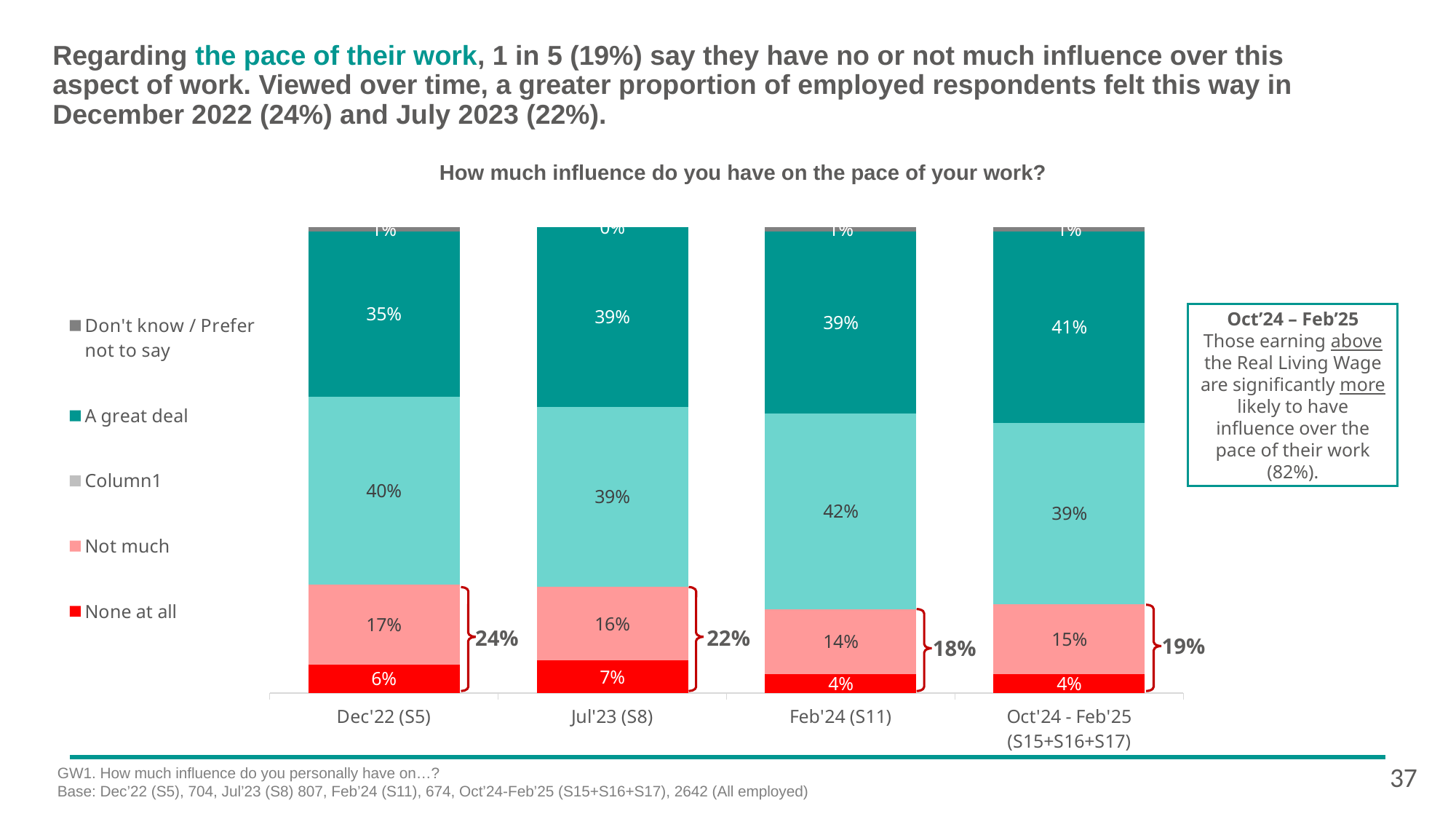
How many time periods are shown on the x axis? 4 Does the 'A great deal' value rise or fall from Dec'22 (S5) to Oct'24 - Feb'25 (S15+S16+S17)? Rise What is the difference between the 'Not much' values for Dec'22 (S5) and Feb'24 (S11)? 3 percentage points How many series does the legend list? 5 Which period has the highest 'A great deal' value? Oct'24 - Feb'25 (S15+S16+S17) What is the 'None at all' value for Jul'23 (S8)? 7% What percentage of respondents said they have 'A great deal' of influence in the Oct'24 - Feb'25 (S15+S16+S17) period? 41% Which is larger: the 'None at all' value for Dec'22 (S5) or for Jul'23 (S8)? Jul'23 (S8) What is the combined 'None at all' and 'Not much' share for Dec'22 (S5), as shown by the bracket? 24% What kind of chart is shown on the slide? Stacked bar chart What is the 'Not much' value for Dec'22 (S5)? 17% Which period has the lowest 'Not much' value? Feb'24 (S11)